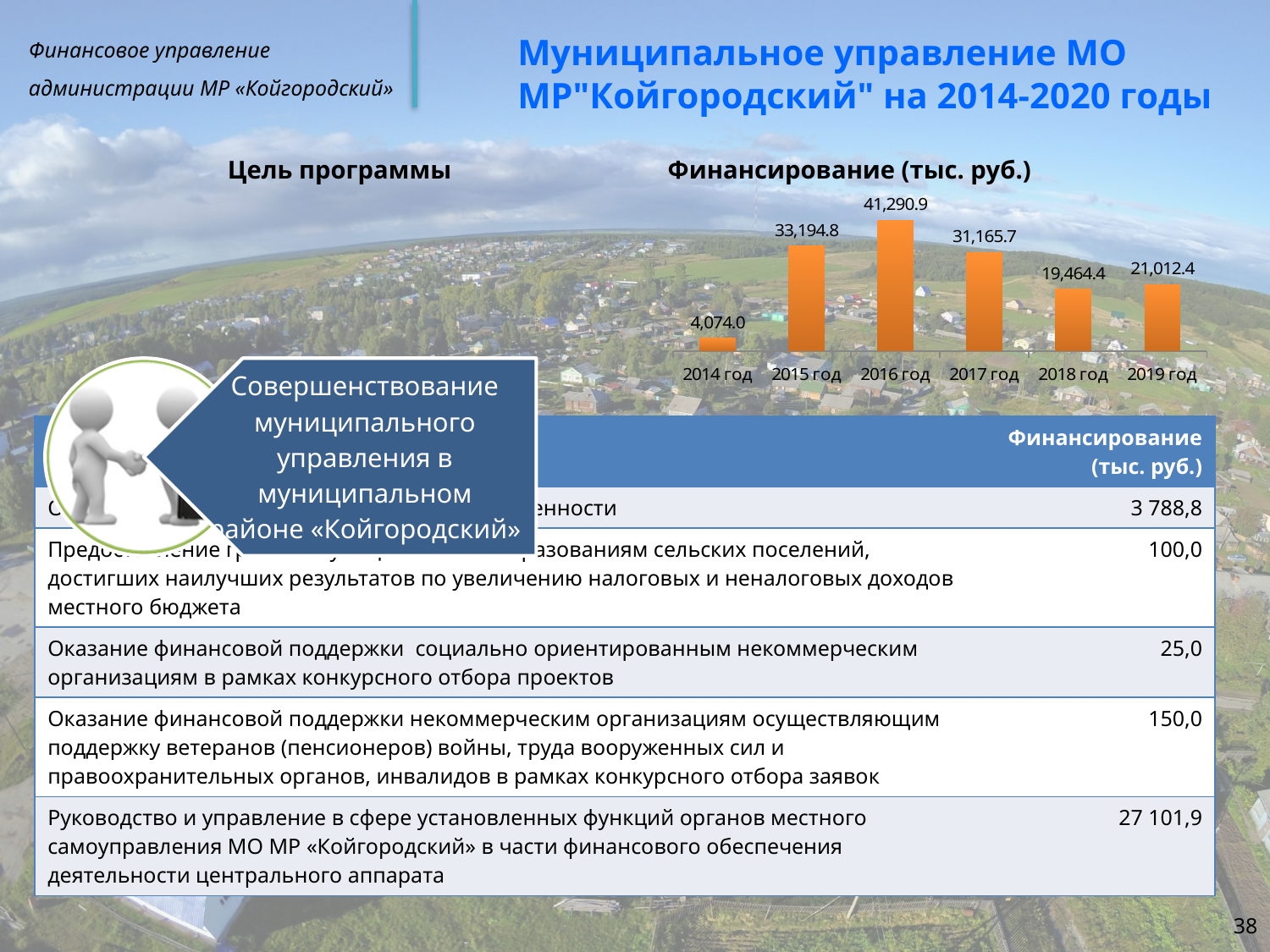
What is the title of the chart? Финансирование (тыс. руб.) How many years are shown in the chart? 6 What is the difference between the values for 2016 год and 2015 год? 8,096.1 What type of chart is shown on the slide? Bar chart Which year has the lowest value in the chart? 2014 год What is the value for 2014 год in the chart? 4,074.0 What is the value for 2018 год in the chart? 19,464.4 Which is larger, the value for 2017 год or the value for 2018 год? 2017 год Which year has the highest value in the chart? 2016 год What is the value for 2016 год in the chart? 41,290.9 What is the value for 2019 год in the chart? 21,012.4 What is the difference between the values for 2019 год and 2018 год? 1,548.0